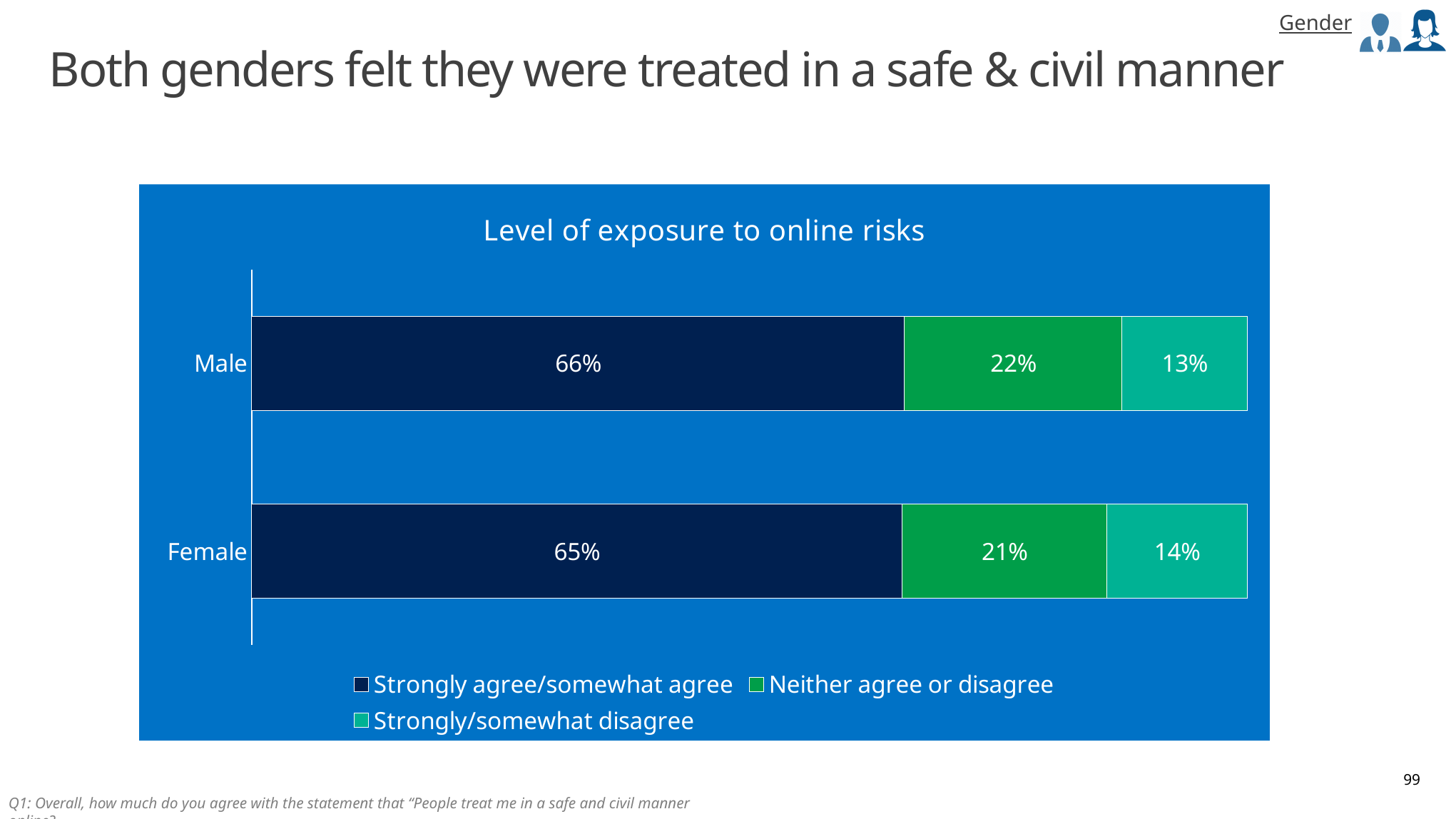
Which gender has the higher share of strongly agree/somewhat agree? Male What percentage of females strongly/somewhat disagree? 14% What percentage of males neither agree or disagree? 22% How many series does the legend list? 3 What percentage of males strongly agree/somewhat agree? 66% What is the title of the chart? Level of exposure to online risks What kind of chart is shown? Stacked bar chart What is the difference between the male and female strongly/somewhat disagree percentages? 1% How many categories (genders) are shown on the chart? 2 What is the difference between the strongly agree/somewhat agree and neither agree or disagree percentages for males? 44% Which legend entry is represented by the dark navy segments? Strongly agree/somewhat agree What percentage of females neither agree or disagree? 21%